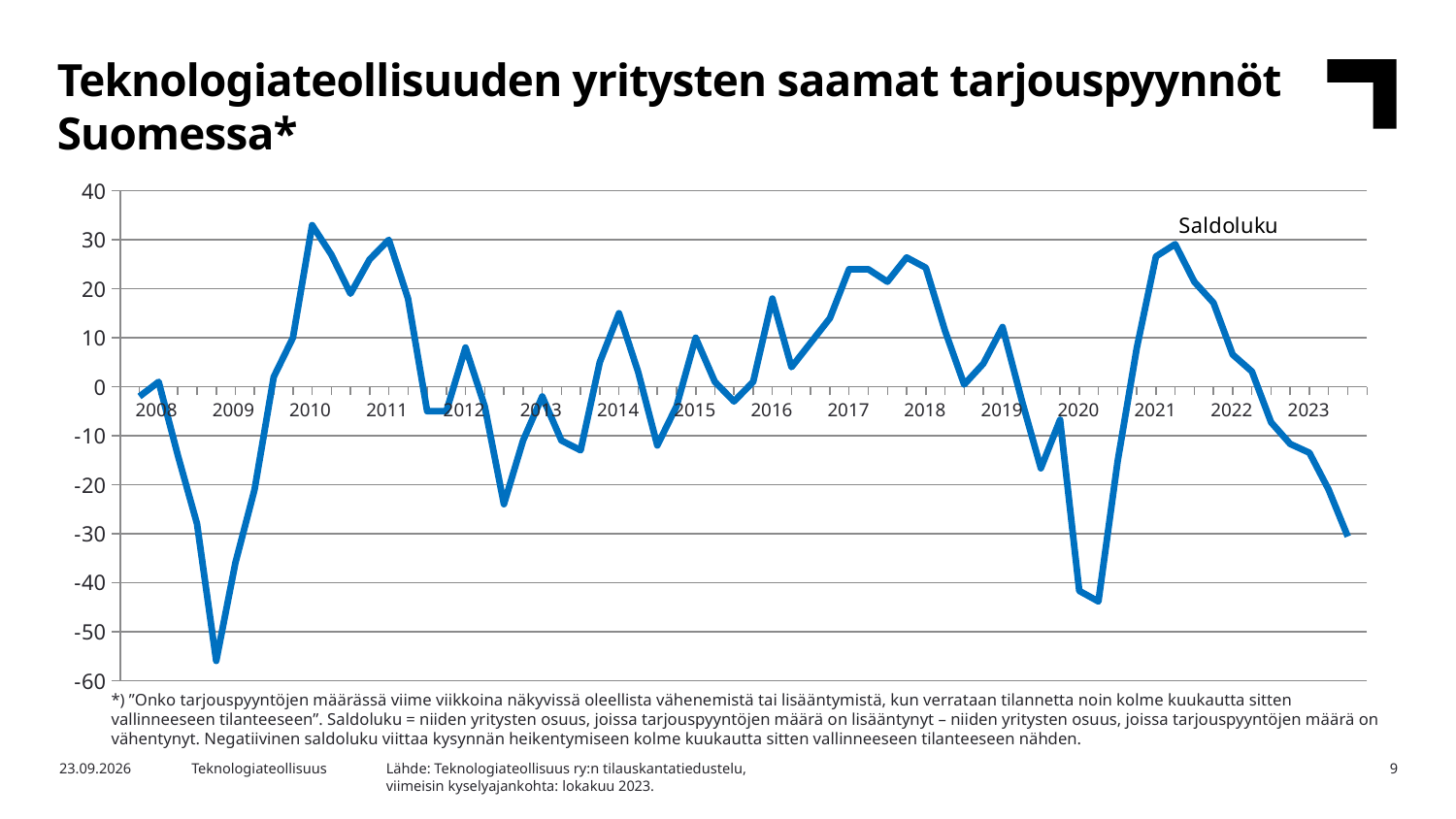
Does the Saldoluku line rise or fall from its 2021 peak to the end of 2023? fall In which year does the Saldoluku line reach its lowest point? 2009 Is the last plotted value of the Saldoluku line in 2023 greater or less than -20? less How many series does the chart show? 1 Is the highest value of the Saldoluku line in 2021 greater or less than 20? greater Which is larger: the lowest value of the Saldoluku line in 2009 or the lowest value in 2020? 2020 What is the name of the series plotted in the chart? Saldoluku Is the lowest value of the Saldoluku line in 2009 greater or less than -50? less How many years are labelled on the x axis of the chart? 16 What kind of chart is shown on the slide? line chart What is the title of the chart on the slide? Saldoluku